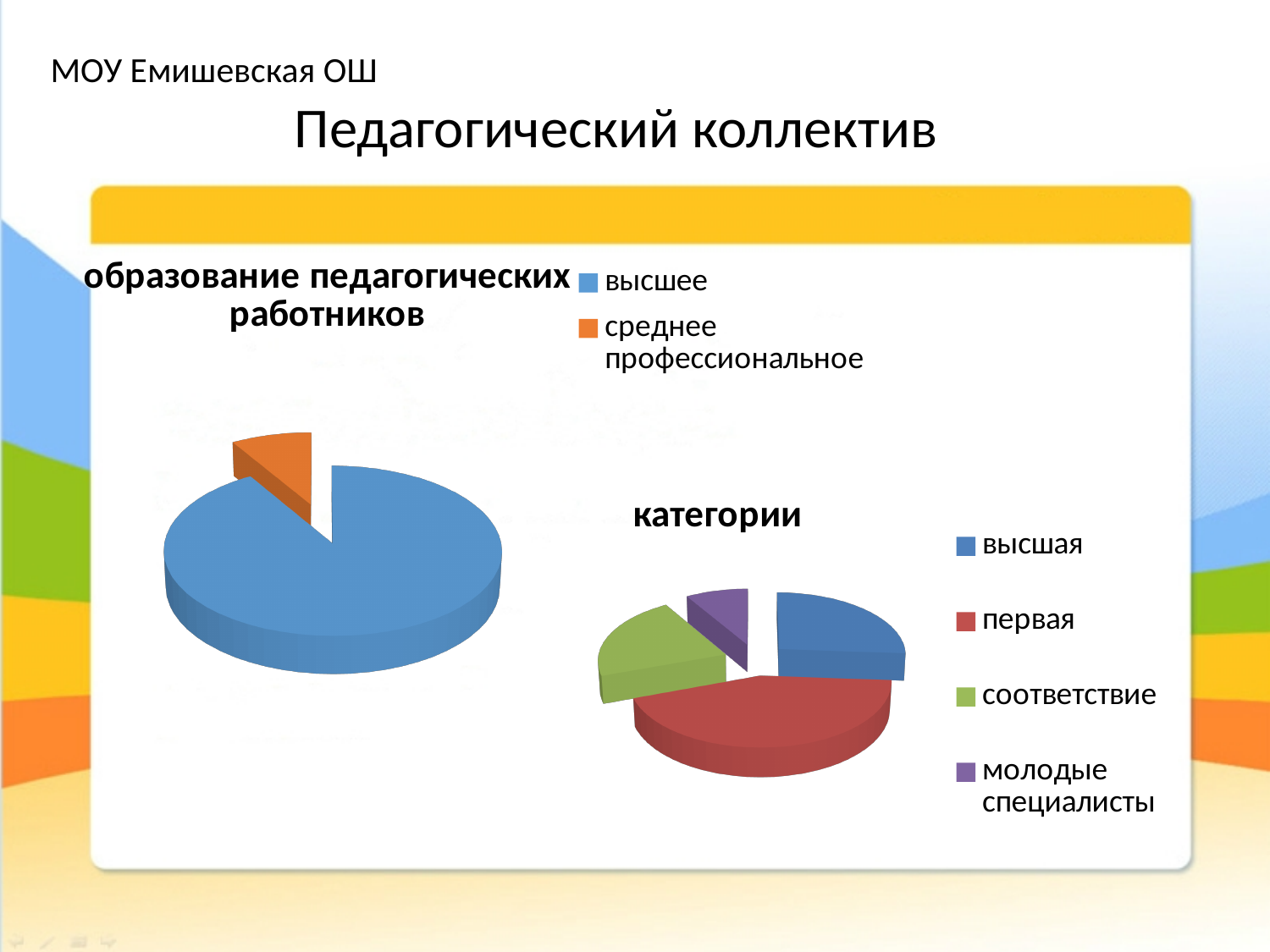
In the chart titled "образование педагогических работников", which category has the largest slice? высшее In the chart titled "категории", which slice is larger: первая or высшая? первая What kind of chart is the chart titled "образование педагогических работников"? pie chart What kind of chart is the chart titled "категории"? pie chart In the chart titled "категории", how many entries does the legend list? 4 In the chart titled "образование педагогических работников", how many slices does the pie have? 2 In the chart titled "образование педагогических работников", which category has the smallest slice? среднее профессиональное In the chart titled "категории", what colour is the slice for молодые специалисты? purple In the chart titled "образование педагогических работников", which slice is larger: высшее or среднее профессиональное? высшее In the chart titled "категории", which category has the smallest slice? молодые специалисты In the chart titled "категории", which category has the largest slice? первая In the chart titled "категории", how many slices does the pie have? 4